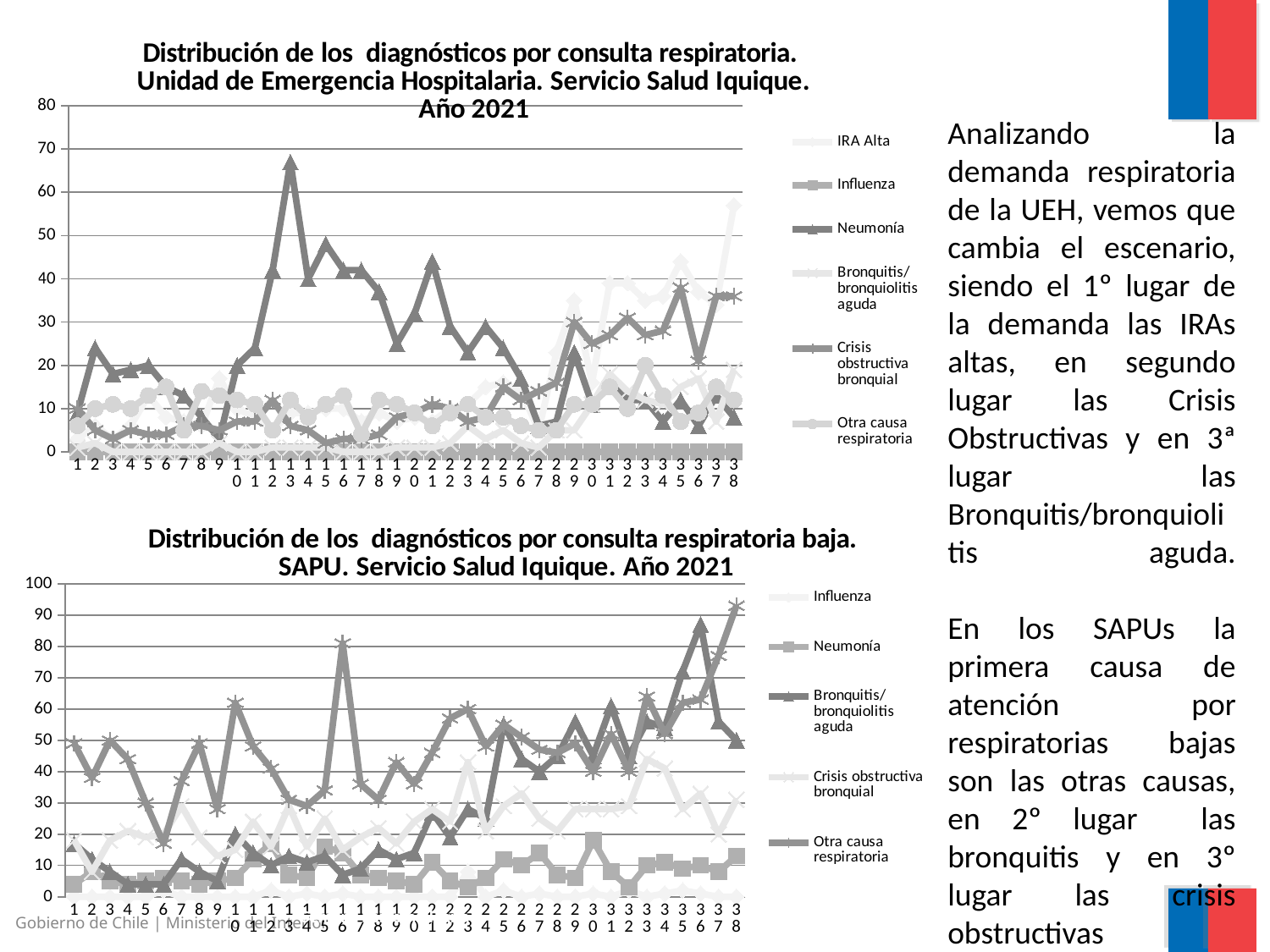
How many series does the legend of the bottom chart (SAPU) list? 5 In the top chart (Unidad de Emergencia Hospitalaria), which series reaches the highest value on the chart? Neumonía How many series does the legend of the top chart (Unidad de Emergencia Hospitalaria) list? 6 In the bottom chart (SAPU), does the Otra causa respiratoria line generally rise or fall from week 30 to week 38? Rise In the top chart (Unidad de Emergencia Hospitalaria), at week 13, which is larger: Crisis obstructiva bronquial or Otra causa respiratoria? Otra causa respiratoria In the bottom chart (SAPU), is the value for Otra causa respiratoria at week 38 greater or less than 80? greater What is the highest value shown on the y axis of the bottom chart (SAPU)? 100 In the bottom chart (SAPU), at week 38, which is larger: Otra causa respiratoria or Bronquitis/bronquiolitis aguda? Otra causa respiratoria In the bottom chart (SAPU), which series reaches the highest value on the chart? Otra causa respiratoria What kind of chart is the top chart, 'Distribución de los diagnósticos por consulta respiratoria. Unidad de Emergencia Hospitalaria'? Line chart In the top chart (Unidad de Emergencia Hospitalaria), is the value for Influenza at week 38 greater or less than 10? less